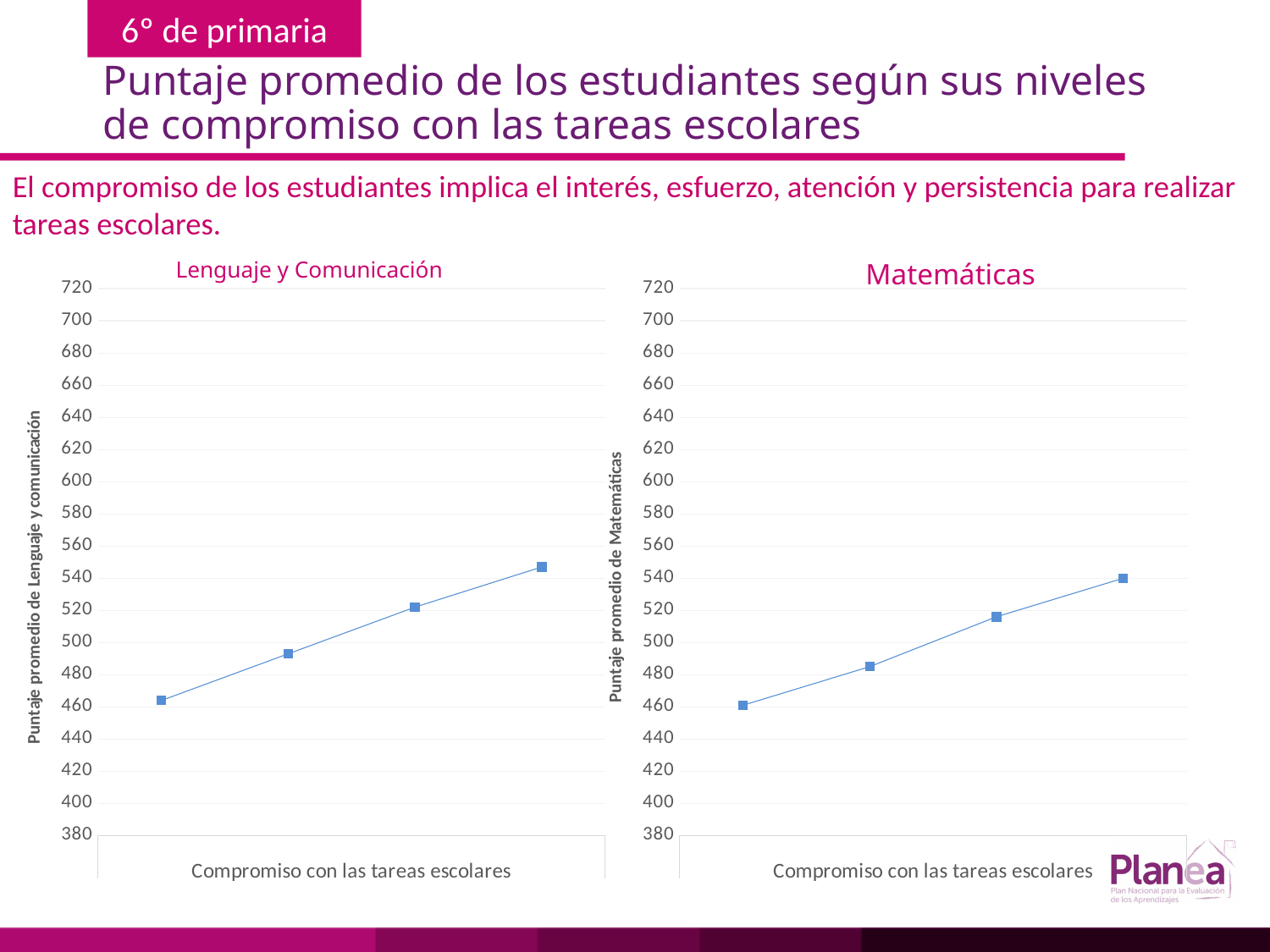
On the Lenguaje y Comunicación chart, do the values rise or fall from left to right along the x axis? rise On the Lenguaje y Comunicación chart, is the value of the leftmost point greater or less than 480? less On the Matemáticas chart, do the values rise or fall from left to right along the x axis? rise How many data points are plotted on the Matemáticas chart? 4 How many data points are plotted on the Lenguaje y Comunicación chart? 4 On the Lenguaje y Comunicación chart, is the value of the rightmost point greater or less than 540? greater On the Matemáticas chart, is the value of the leftmost point greater or less than 480? less What kind of chart is the Lenguaje y Comunicación chart? line chart What is the y-axis label on the Lenguaje y Comunicación chart? Puntaje promedio de Lenguaje y comunicación What is the x-axis label on the Matemáticas chart? Compromiso con las tareas escolares What kind of chart is the Matemáticas chart? line chart